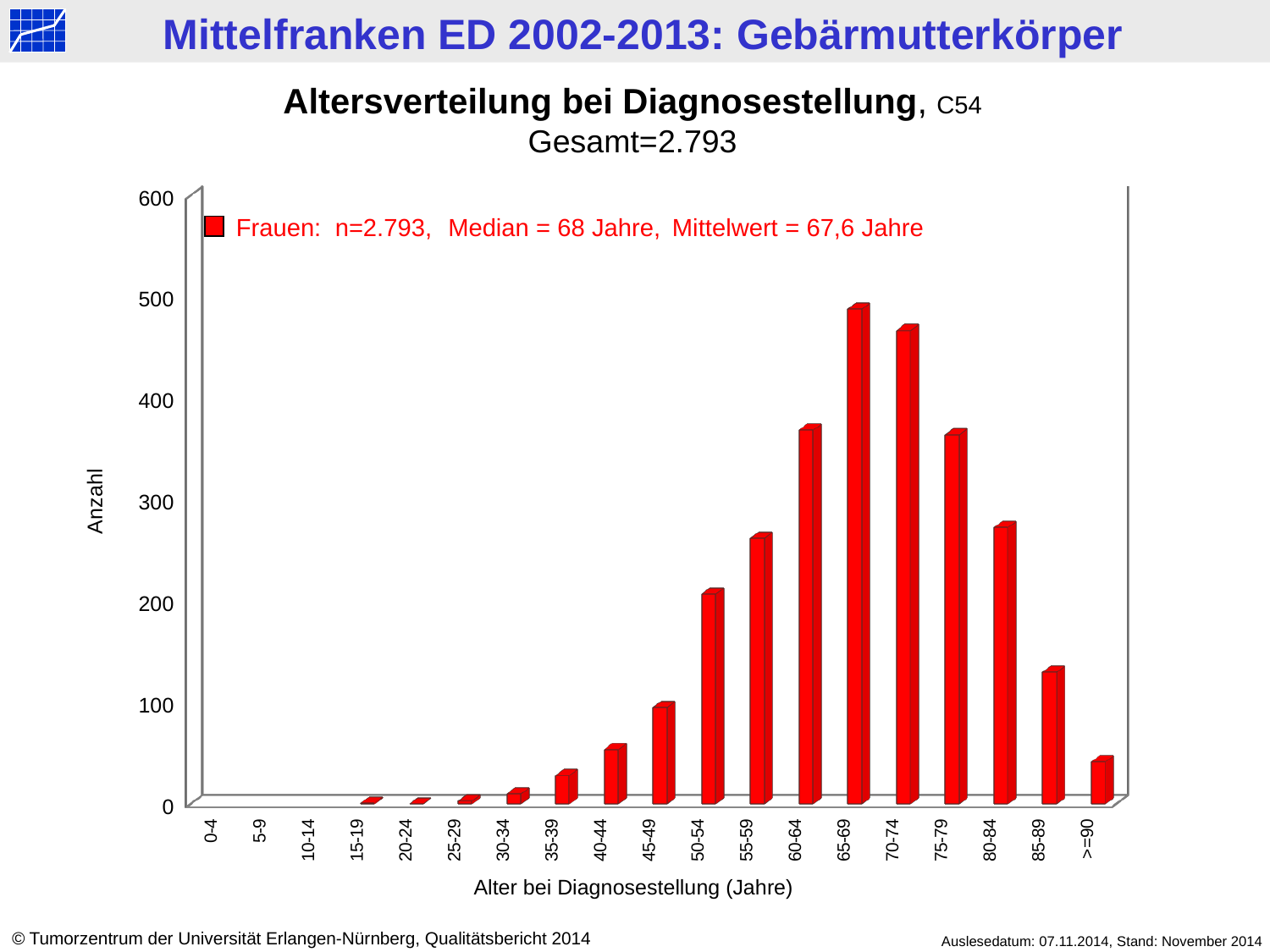
Which age group has the larger value, 65-69 or 55-59? 65-69 How do the values change along the x axis from the 35-39 age group to the 65-69 age group? they rise What median age is stated in the legend of the chart? 68 Jahre Is the value for the 80-84 age group greater or less than 200? greater Is the value for the 50-54 age group greater or less than 300? less Which age group has the larger value, 85-89 or 40-44? 85-89 Is the value for the 45-49 age group greater or less than 200? less How many age groups are shown on the x axis of the chart? 19 Which age group has the highest number of cases in the chart? 65-69 What kind of chart is shown on the slide? bar chart How many series does the legend of the chart list? 1